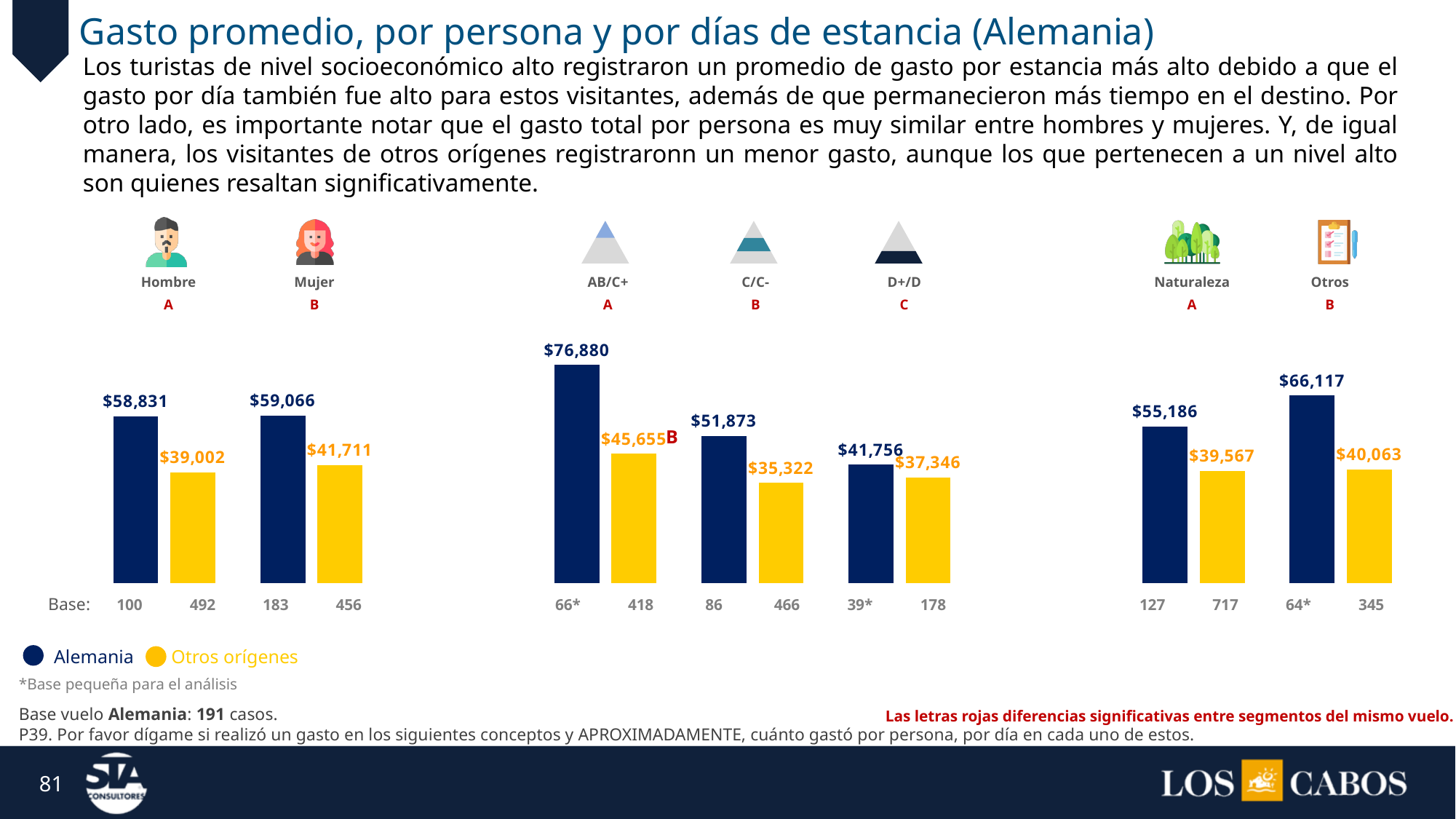
Which category has the highest Alemania value? AB/C+ What is the difference between the Alemania and Otros orígenes values for AB/C+? $31,225 How many categories are shown along the x axis? 7 How many series does the legend list? 2 What is the difference between the Alemania values for Otros and Naturaleza? $10,931 What is the Alemania value for the C/C- segment? $51,873 Which category has the lowest Otros orígenes value? C/C- Which category has the lowest Alemania value? D+/D Which is larger for Alemania: the value for Hombre or for Mujer? Mujer What is the Alemania value for Hombre? $58,831 What is the Otros orígenes value for Naturaleza? $39,567 What is the Otros orígenes value for Mujer? $41,711